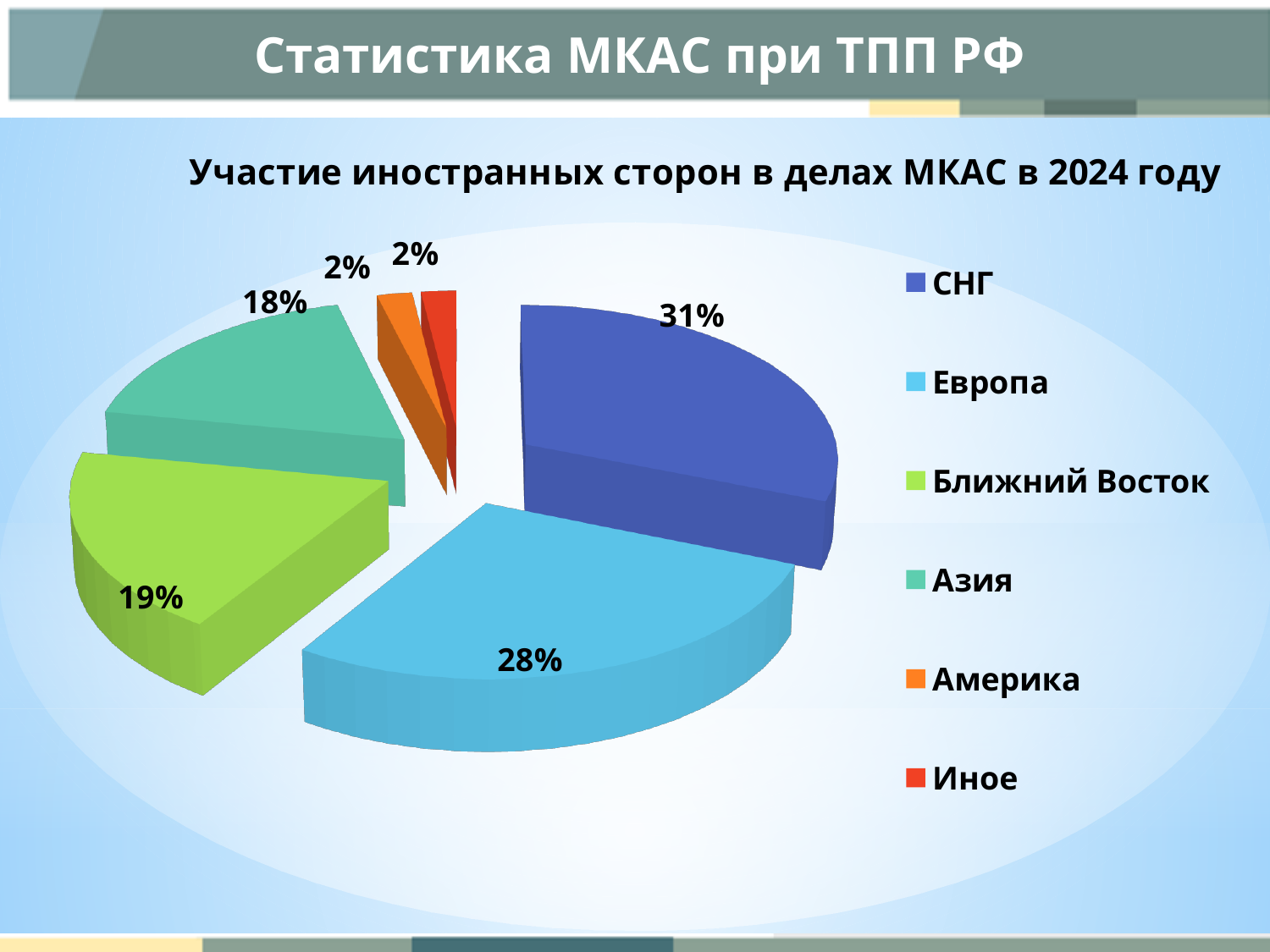
What is the value for Азия? 18% What colour is the slice for Иное? red What is the value for Ближний Восток? 19% Which is larger, the share for Ближний Восток or the share for Азия? Ближний Восток What kind of chart is shown on the slide? pie chart How many categories does the legend list? 6 Which category has the largest share of the pie? СНГ What share of the pie does Европа have? 28% What is the value for Америка? 2% What is the difference between the shares of СНГ and Европа? 3% What is the title of the chart? Участие иностранных сторон в делах МКАС в 2024 году What share of the pie does СНГ have? 31%